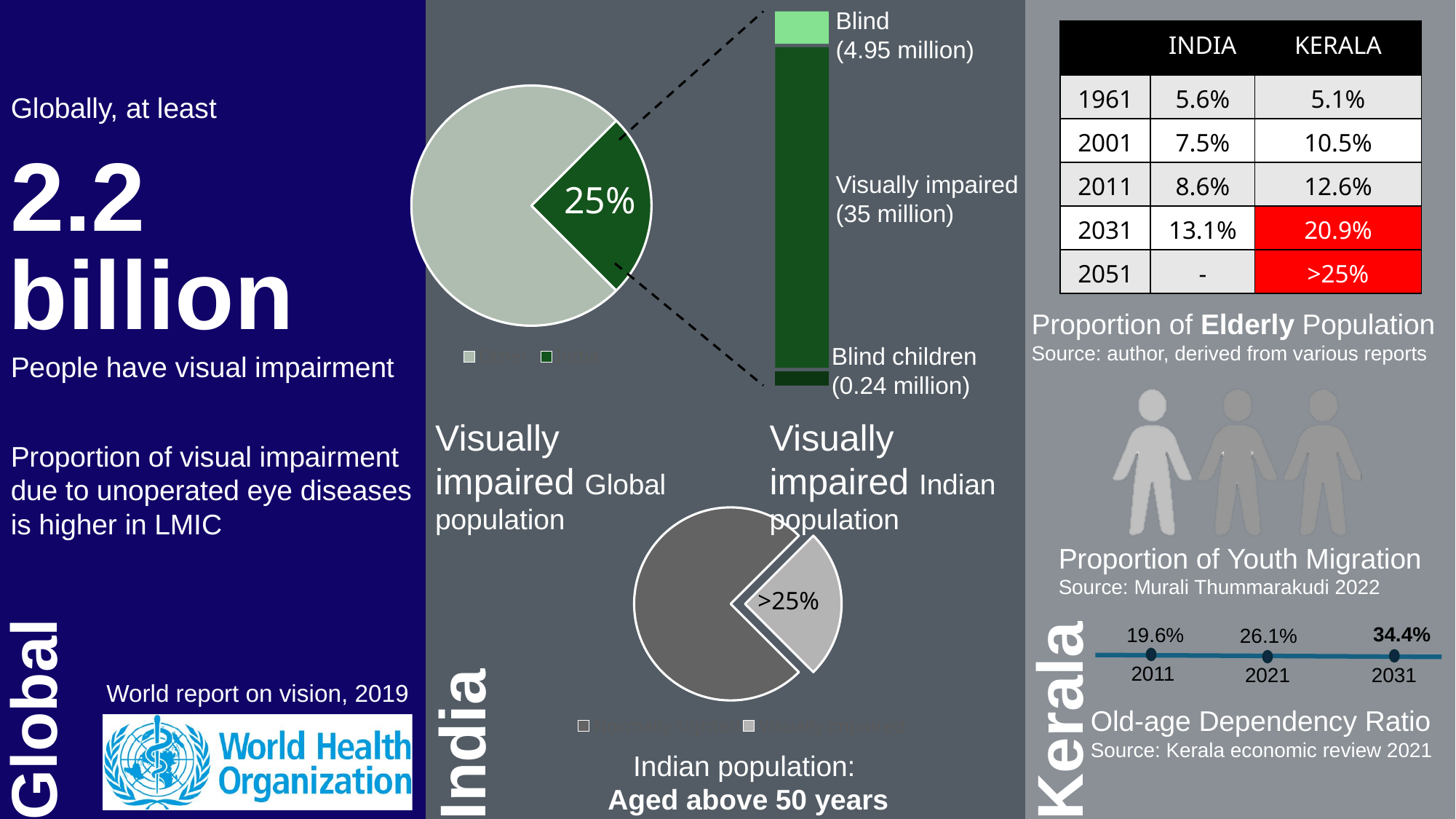
In the stacked bar for the visually impaired Indian population, which segment is the smallest? Blind children (0.24 million) In the stacked bar for the visually impaired Indian population, how many segments are shown? 3 In the stacked bar for the visually impaired Indian population, which segment is the largest? Visually impaired (35 million) In the pie chart for the Indian population aged above 50 years, what value is printed on the light grey slice? >25% In the Old-age Dependency Ratio chart for Kerala, what is the value for 2021? 26.1% In the stacked bar breaking down the visually impaired Indian population, how many people are labelled as Visually impaired? 35 million In the Old-age Dependency Ratio chart for Kerala, what is the difference between the 2031 and 2011 values? 14.8% In the 'Visually impaired Global population' pie chart, what percentage is shown on the dark green slice? 25% In the Old-age Dependency Ratio chart for Kerala, do the values rise or fall from 2011 to 2031? rise In the stacked bar breaking down the visually impaired Indian population, how many people are labelled as Blind? 4.95 million What kind of chart is used to show the visually impaired global population? pie chart In the stacked bar breaking down the visually impaired Indian population, how many people are labelled as Blind children? 0.24 million